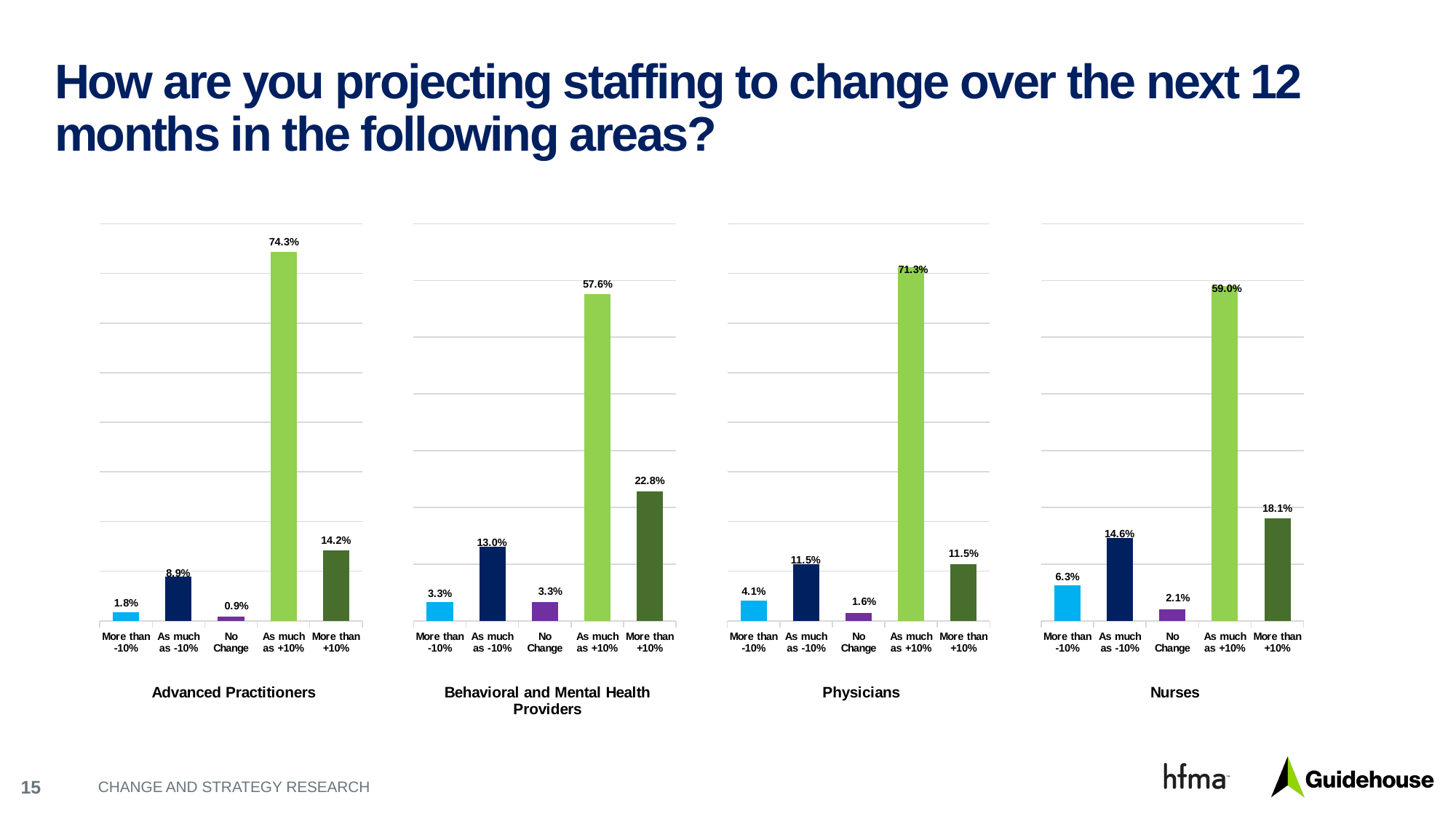
In the Advanced Practitioners chart, which category has the lowest value? No Change In the Nurses chart, what is the value for "More than -10%"? 6.3% In the Behavioral and Mental Health Providers chart, which is larger: "As much as -10%" or "More than +10%"? More than +10% How many categories are shown in the Physicians chart? 5 In the Advanced Practitioners chart, what is the value for "As much as +10%"? 74.3% How many charts are shown on the slide? 4 In the Physicians chart, what is the value for "No Change"? 1.6% In the Behavioral and Mental Health Providers chart, what is the value for "More than +10%"? 22.8% What kind of chart is the Nurses chart? Bar chart In the Nurses chart, what is the difference between "More than +10%" and "As much as -10%"? 3.5% In the Nurses chart, which category has the highest value? As much as +10% In the Physicians chart, what is the difference between "As much as +10%" and "More than +10%"? 59.8%